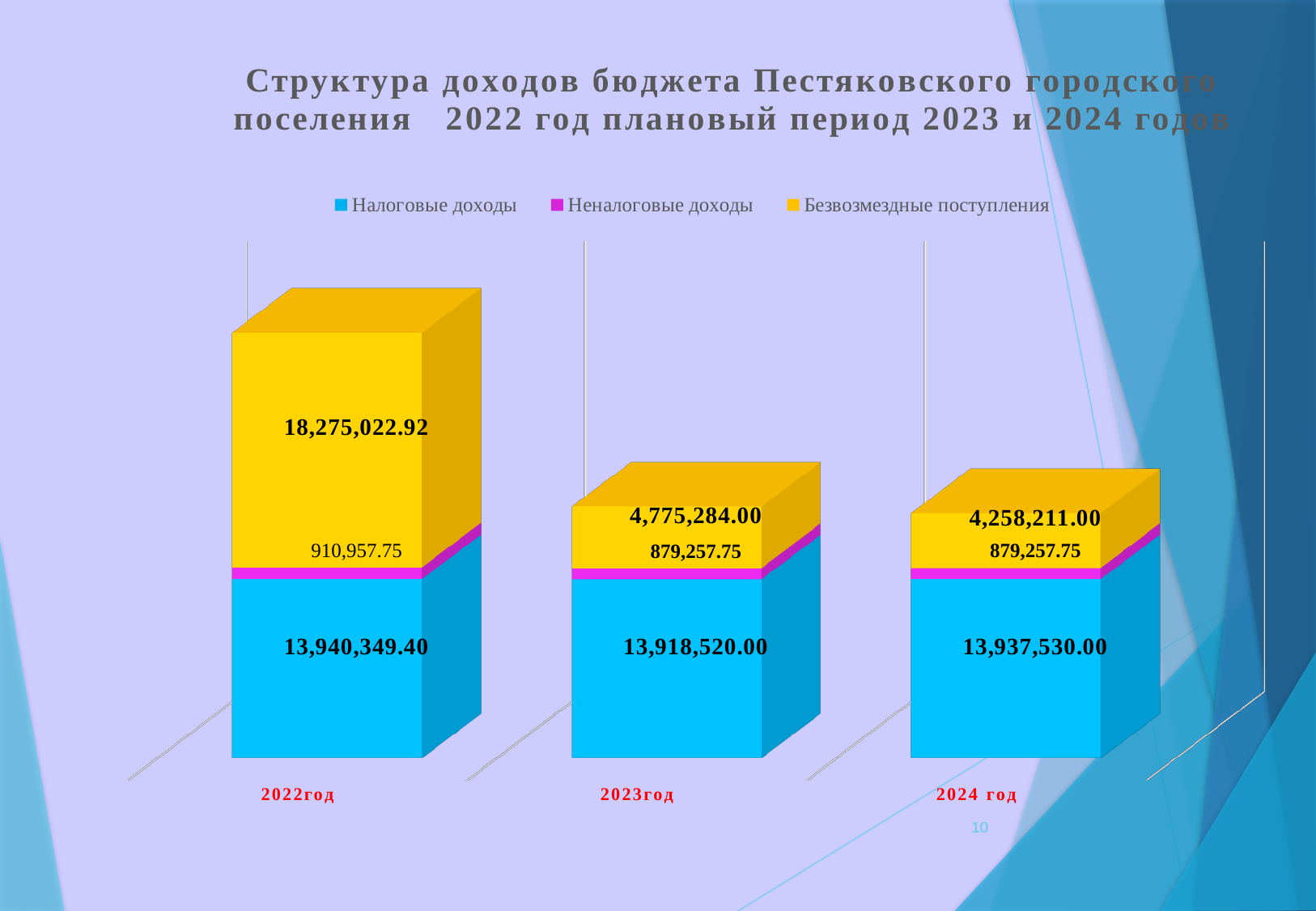
Which year has the lowest value for Безвозмездные поступления? 2024 год What type of chart is shown on the slide? Stacked bar chart What is the value of Безвозмездные поступления for 2022год? 18,275,022.92 Which year has the highest value for Безвозмездные поступления? 2022год Which is larger in 2022год: Налоговые доходы or Безвозмездные поступления? Безвозмездные поступления What is the value of Неналоговые доходы for 2024 год? 879,257.75 How many year categories are shown on the x axis? 3 What is the difference between Безвозмездные поступления in 2023год and 2024 год? 517,073.00 How many series does the legend list? 3 What is the total of the stacked bar for 2023год? 19,573,061.75 What is the value of Налоговые доходы for 2023год? 13,918,520.00 Which colour represents Неналоговые доходы in the legend? Magenta